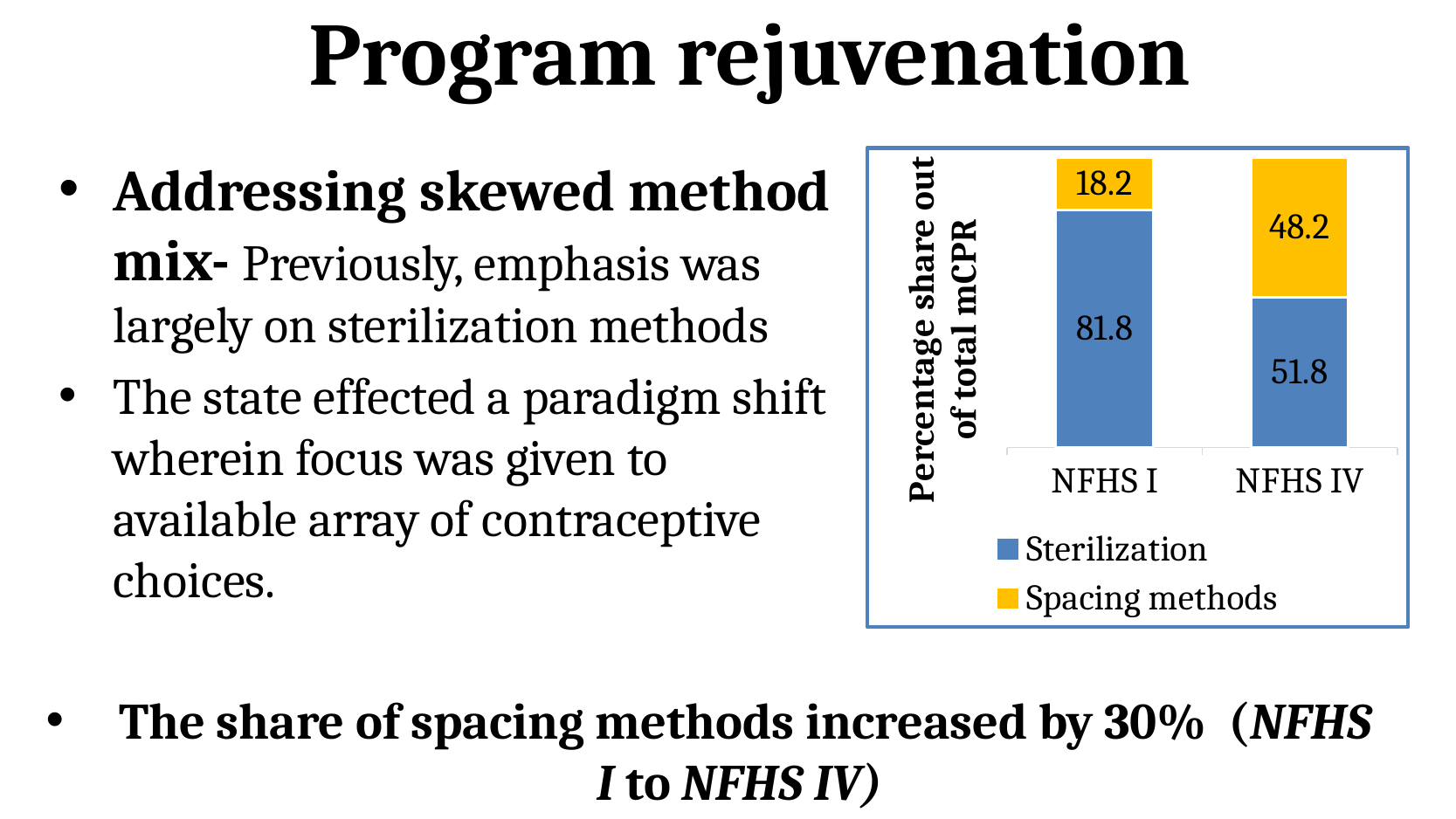
Which category has the higher Spacing methods value, NFHS I or NFHS IV? NFHS IV What is the Spacing methods value for NFHS I? 18.2 Which category has the lowest Sterilization value? NFHS IV What is the Sterilization value for NFHS I? 81.8 What is the Sterilization value for NFHS IV? 51.8 What kind of chart is shown on the slide? Stacked bar chart What is the label on the vertical axis of the chart? Percentage share out of total mCPR What is the total of the stacked bar for NFHS I? 100 How many categories are shown on the x axis? 2 What is the Spacing methods value for NFHS IV? 48.2 How many series does the legend list? 2 What is the difference between the Spacing methods values for NFHS IV and NFHS I? 30